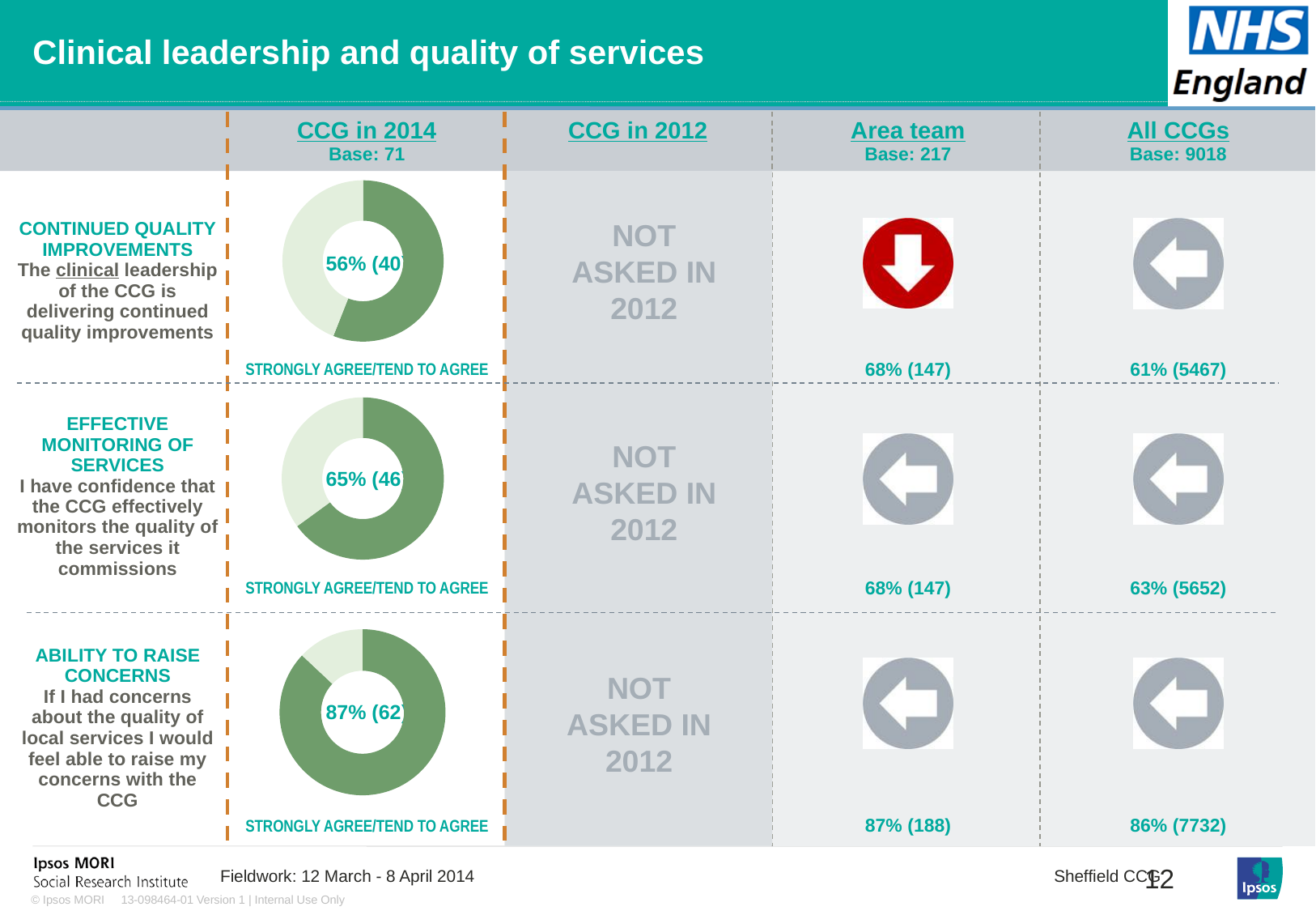
In the 'CCG in 2014' column, what value is shown in the donut chart for 'Ability to raise concerns'? 87% (62) What label appears beneath each donut chart in the 'CCG in 2014' column? Strongly agree/tend to agree What kind of chart is used in the 'CCG in 2014' column to show each result? Donut (pie) chart Which of the three 'CCG in 2014' donut charts shows the highest percentage? Ability to raise concerns What share of the 'Ability to raise concerns' donut chart is taken by the dark green (agree) segment? 87% How many donut charts are shown on the slide? 3 In the 'CCG in 2014' column, what value is shown in the donut chart for 'Continued quality improvements'? 56% (40) In the 'CCG in 2014' column, what is the difference in percentage points between the 'Effective monitoring of services' donut and the 'Continued quality improvements' donut? 9 percentage points In the 'CCG in 2014' column, what value is shown in the donut chart for 'Effective monitoring of services'? 65% (46) In the 'CCG in 2014' column, what is the difference in percentage points between the 'Ability to raise concerns' donut and the 'Continued quality improvements' donut? 31 percentage points In the 'CCG in 2014' column, which donut chart shows a larger percentage: 'Effective monitoring of services' or 'Continued quality improvements'? Effective monitoring of services Which of the three 'CCG in 2014' donut charts shows the lowest percentage? Continued quality improvements